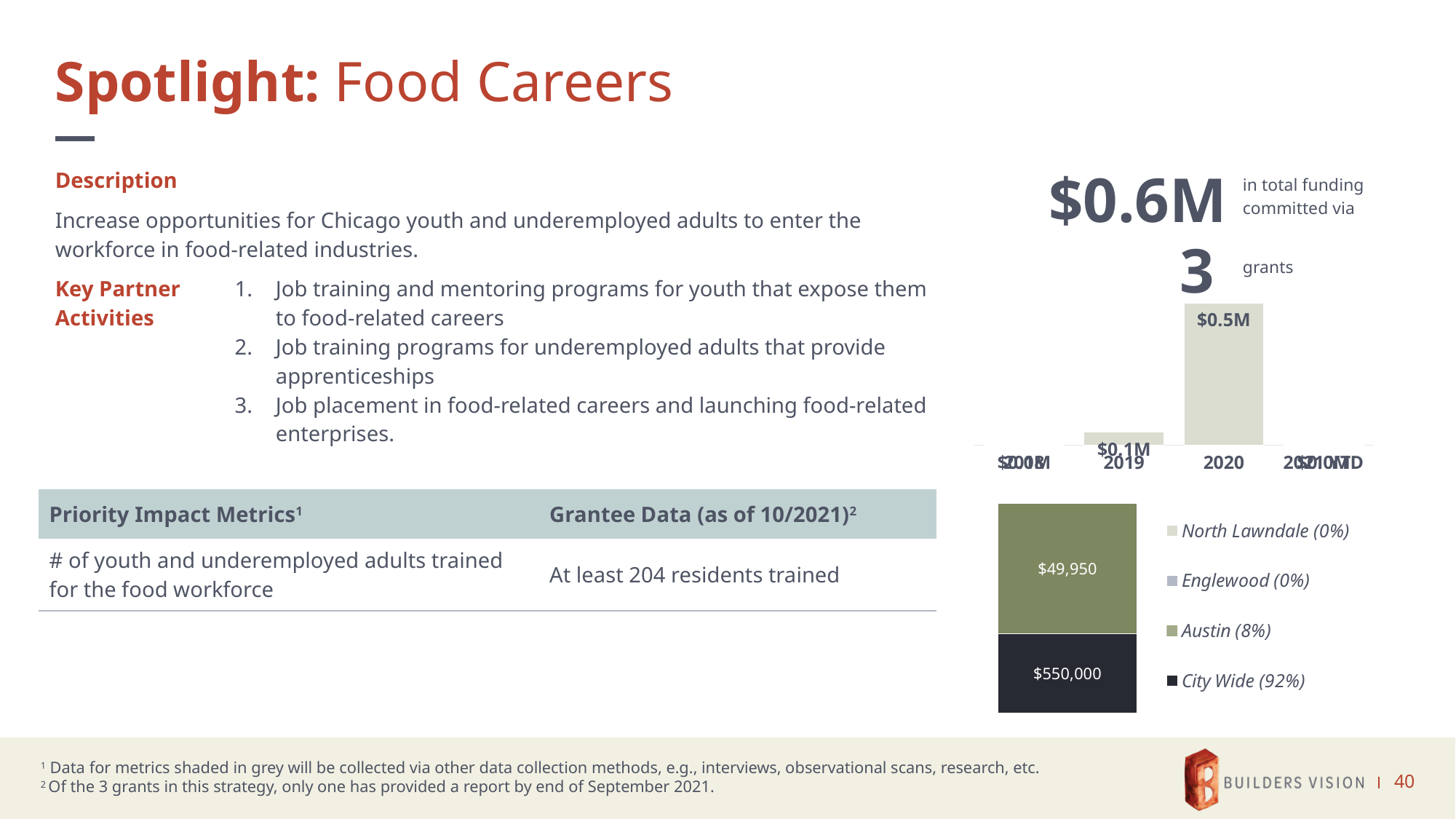
In the stacked bar chart at the bottom right, what is the value for City Wide? $550,000 In the stacked bar chart at the bottom right, what is the value for Austin? $49,950 In the bar chart by year, which year has the highest value? 2020 What kind of chart is the chart by year at the top right of the slide? bar chart In the bar chart by year, what is the difference between the 2020 and 2019 values? $0.4M In the stacked bar chart at the bottom right, what share does City Wide represent? 92% In the bar chart by year, what is the value for 2019? $0.1M In the bar chart by year, what is the value for 2020? $0.5M In the bar chart by year, which is larger, the value for 2019 or the value for 2020? 2020 In the stacked bar chart at the bottom right, how many series does the legend list? 4 In the stacked bar chart at the bottom right, which legend entry is shown in the darkest colour? City Wide (92%) In the stacked bar chart at the bottom right, what share does Austin represent? 8%